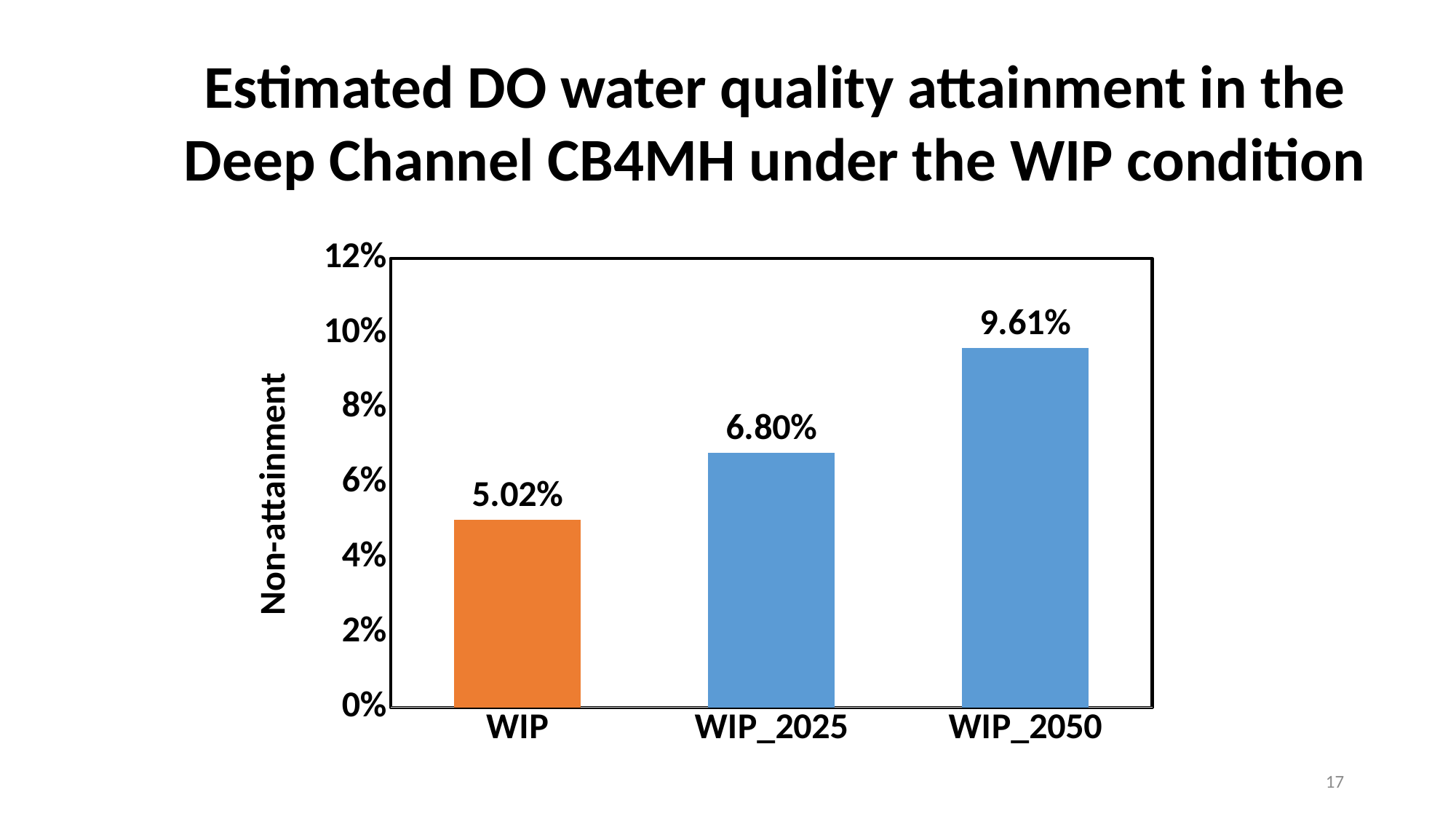
What is the difference between the non-attainment values for WIP_2050 and WIP? 4.59% What kind of chart is shown on the slide? bar chart Do the non-attainment values rise or fall from WIP to WIP_2050? rise What is the non-attainment value for WIP_2050? 9.61% Which category has the highest non-attainment value? WIP_2050 What is the difference between the non-attainment values for WIP_2025 and WIP? 1.78% Which has a larger non-attainment value, WIP_2025 or WIP_2050? WIP_2050 What is the non-attainment value for WIP_2025? 6.80% How many categories are shown on the x axis? 3 What is the non-attainment value for WIP? 5.02% Is the value for WIP_2050 greater or less than 8%? greater Which category has the lowest non-attainment value? WIP